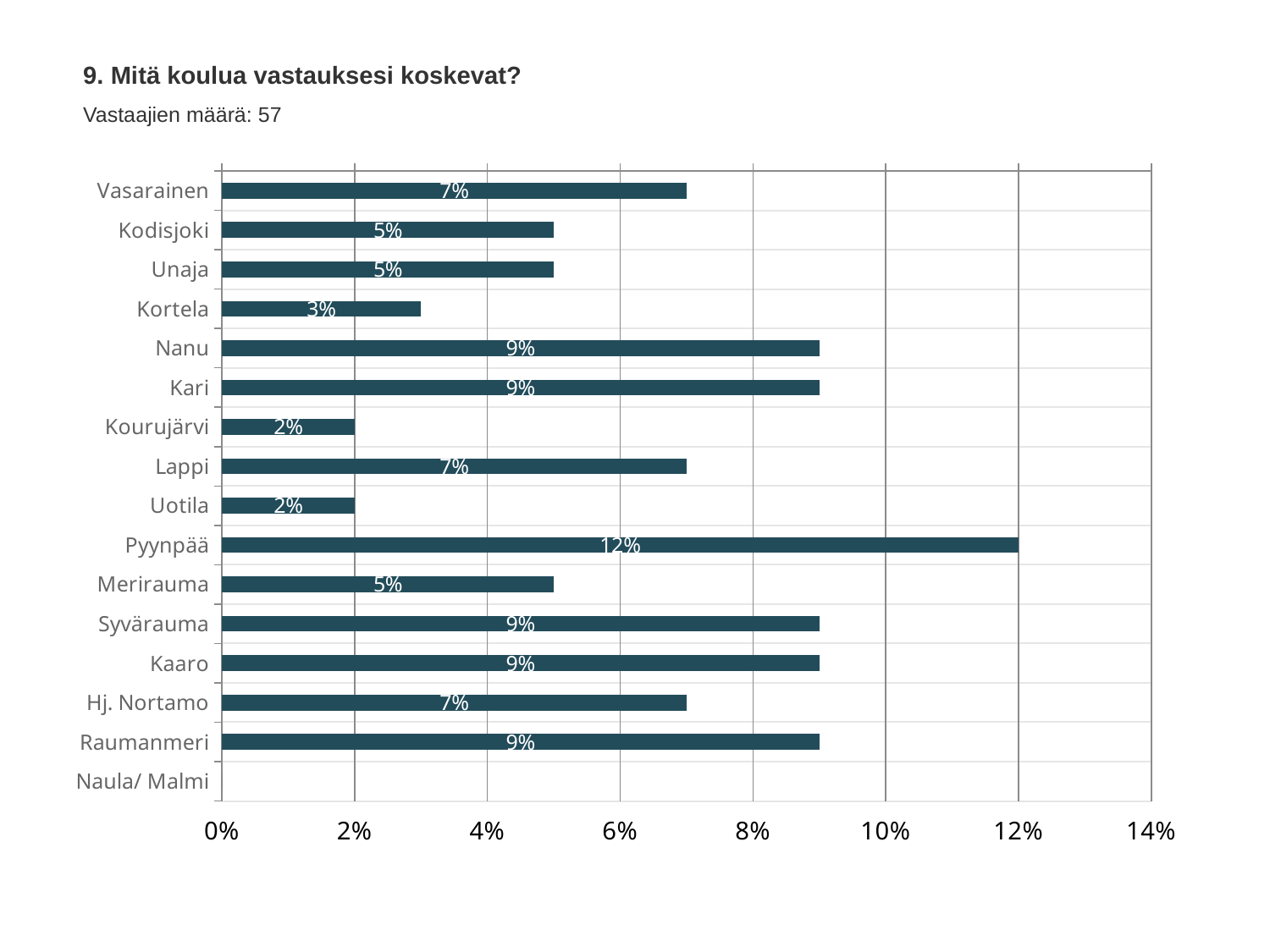
What is the difference between the values for Pyynpää and Kortela? 9% What is the value for Pyynpää? 12% What is the number of respondents (Vastaajien määrä) shown on the slide? 57 What is the value for Kourujärvi? 2% What kind of chart is shown on the slide? Bar chart Which is larger, the value for Merirauma or the value for Kaaro? Kaaro What is the difference between the values for Nanu and Kodisjoki? 4% What is the value for Kortela? 3% Which is larger, the value for Lappi or the value for Uotila? Lappi Which school has the highest value? Pyynpää What is the value for Hj. Nortamo? 7% How many schools are listed on the y axis? 16